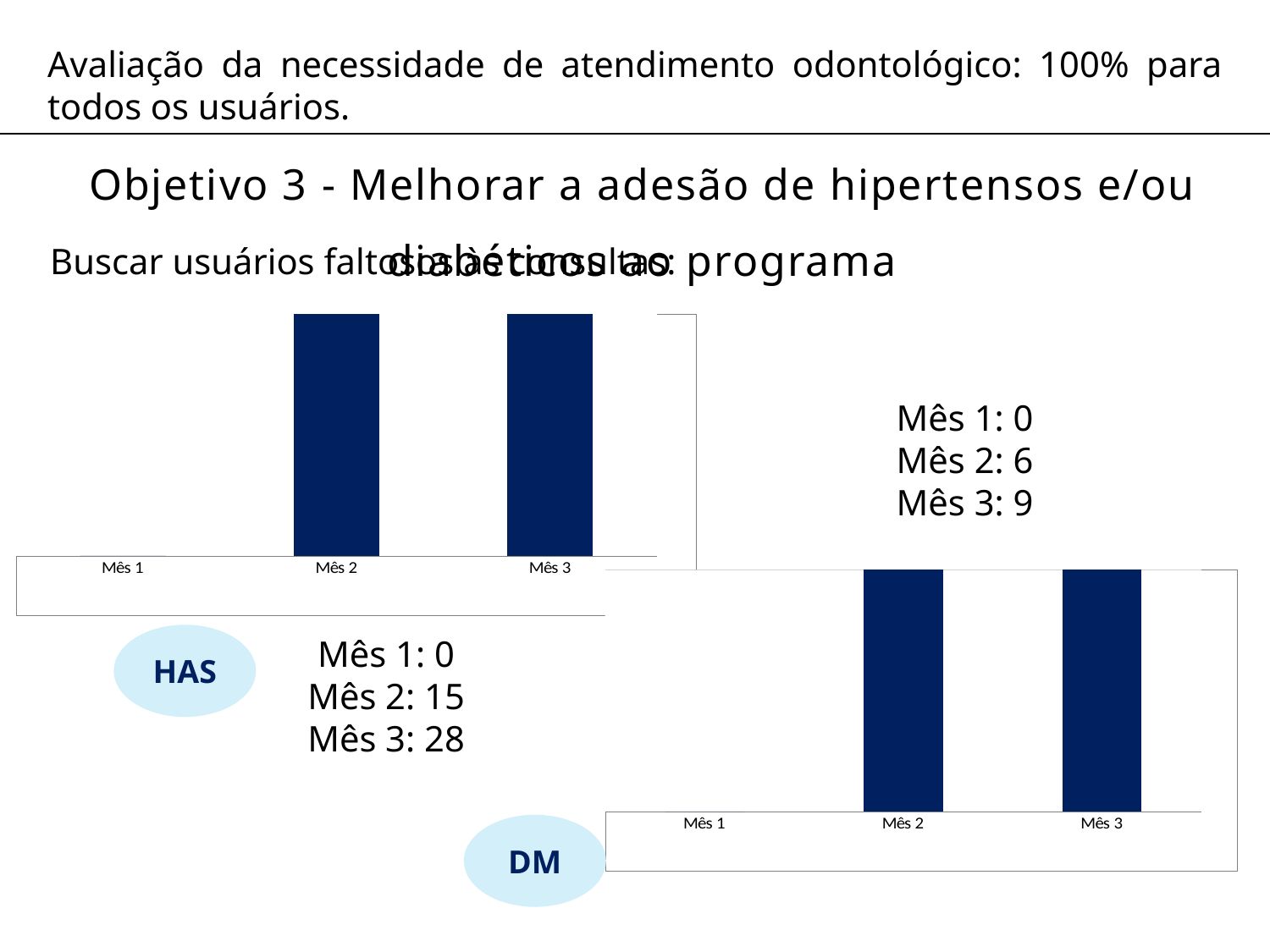
According to the values printed beside the DM chart, what is the value for Mês 3? 9 How many categories are shown on the x axis of the DM chart? 3 According to the values printed beside the DM chart, what is the value for Mês 1? 0 How many categories are shown on the x axis of the HAS chart? 3 According to the values printed beside the HAS chart, what is the value for Mês 3? 28 What kind of chart is the HAS chart on the left of the slide? bar chart In the DM chart, which month has the lowest value? Mês 1 What are the category labels on the x axis of the DM chart? Mês 1, Mês 2, Mês 3 How many bar charts are shown on the slide? 2 In the HAS chart, which month has the lowest value? Mês 1 What kind of chart is the DM chart on the right of the slide? bar chart According to the values printed beside the HAS chart, what is the value for Mês 2? 15